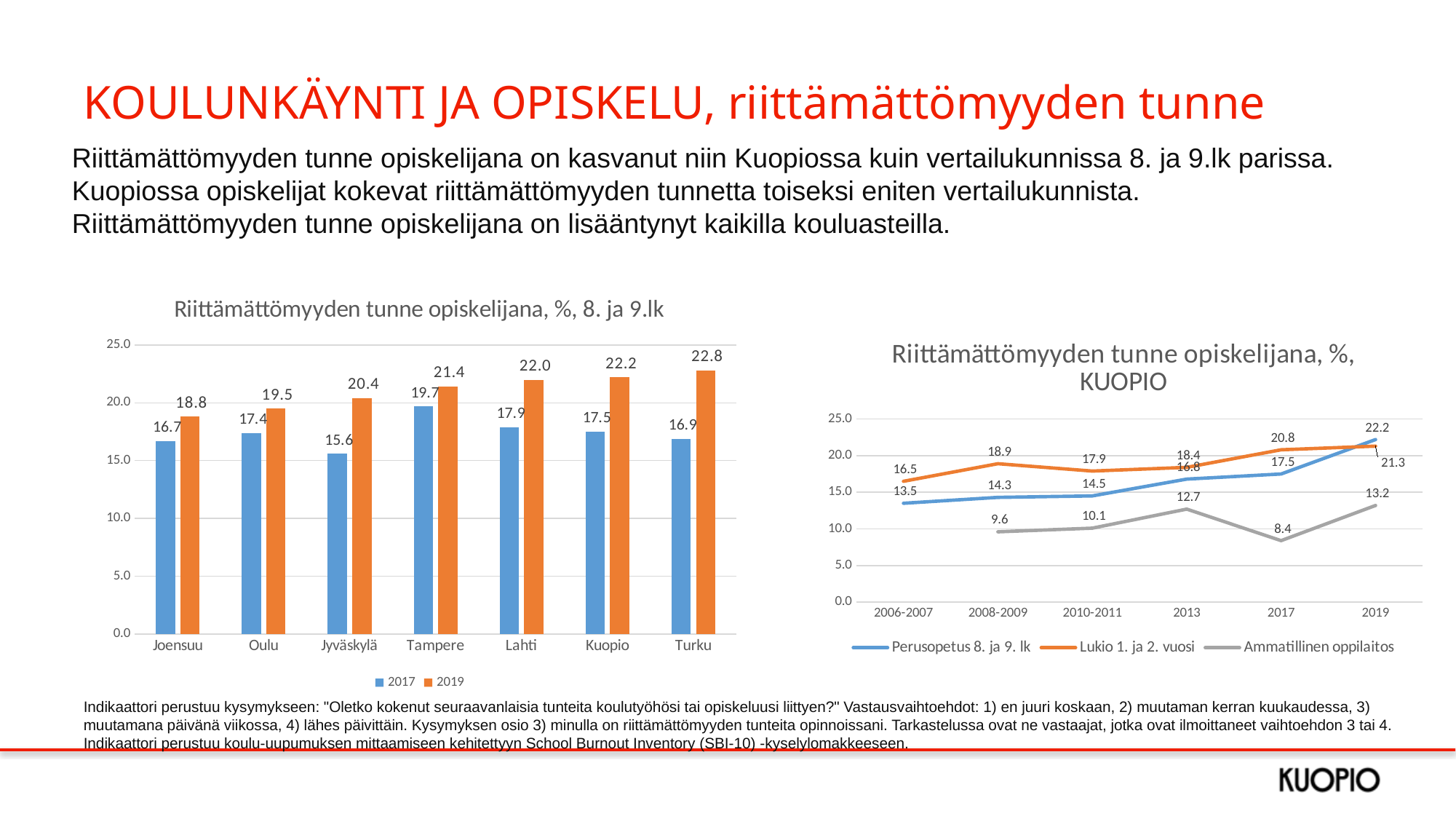
What type of chart is 'Riittämättömyyden tunne opiskelijana, %, 8. ja 9.lk'? Bar chart In the chart 'Riittämättömyyden tunne opiskelijana, %, KUOPIO', does the Perusopetus 8. ja 9. lk line rise or fall from 2006-2007 to 2019? Rise In the chart 'Riittämättömyyden tunne opiskelijana, %, 8. ja 9.lk', what is the 2017 value for Jyväskylä? 15.6 In the chart 'Riittämättömyyden tunne opiskelijana, %, KUOPIO', how many series does the legend list? 3 In the chart 'Riittämättömyyden tunne opiskelijana, %, KUOPIO', what is the value for Ammatillinen oppilaitos in 2017? 8.4 In the chart 'Riittämättömyyden tunne opiskelijana, %, 8. ja 9.lk', what is the 2019 value for Kuopio? 22.2 In the chart 'Riittämättömyyden tunne opiskelijana, %, 8. ja 9.lk', how many cities are shown on the x axis? 7 In the chart 'Riittämättömyyden tunne opiskelijana, %, 8. ja 9.lk', which city has the lowest 2017 value? Jyväskylä In the chart 'Riittämättömyyden tunne opiskelijana, %, KUOPIO', what is the value for Perusopetus 8. ja 9. lk in 2006-2007? 13.5 In the chart 'Riittämättömyyden tunne opiskelijana, %, KUOPIO', which is larger in 2019: Perusopetus 8. ja 9. lk or Ammatillinen oppilaitos? Perusopetus 8. ja 9. lk In the chart 'Riittämättömyyden tunne opiskelijana, %, 8. ja 9.lk', what is the difference between the 2019 and 2017 values for Kuopio? 4.7 In the chart 'Riittämättömyyden tunne opiskelijana, %, 8. ja 9.lk', which city has the highest 2019 value? Turku